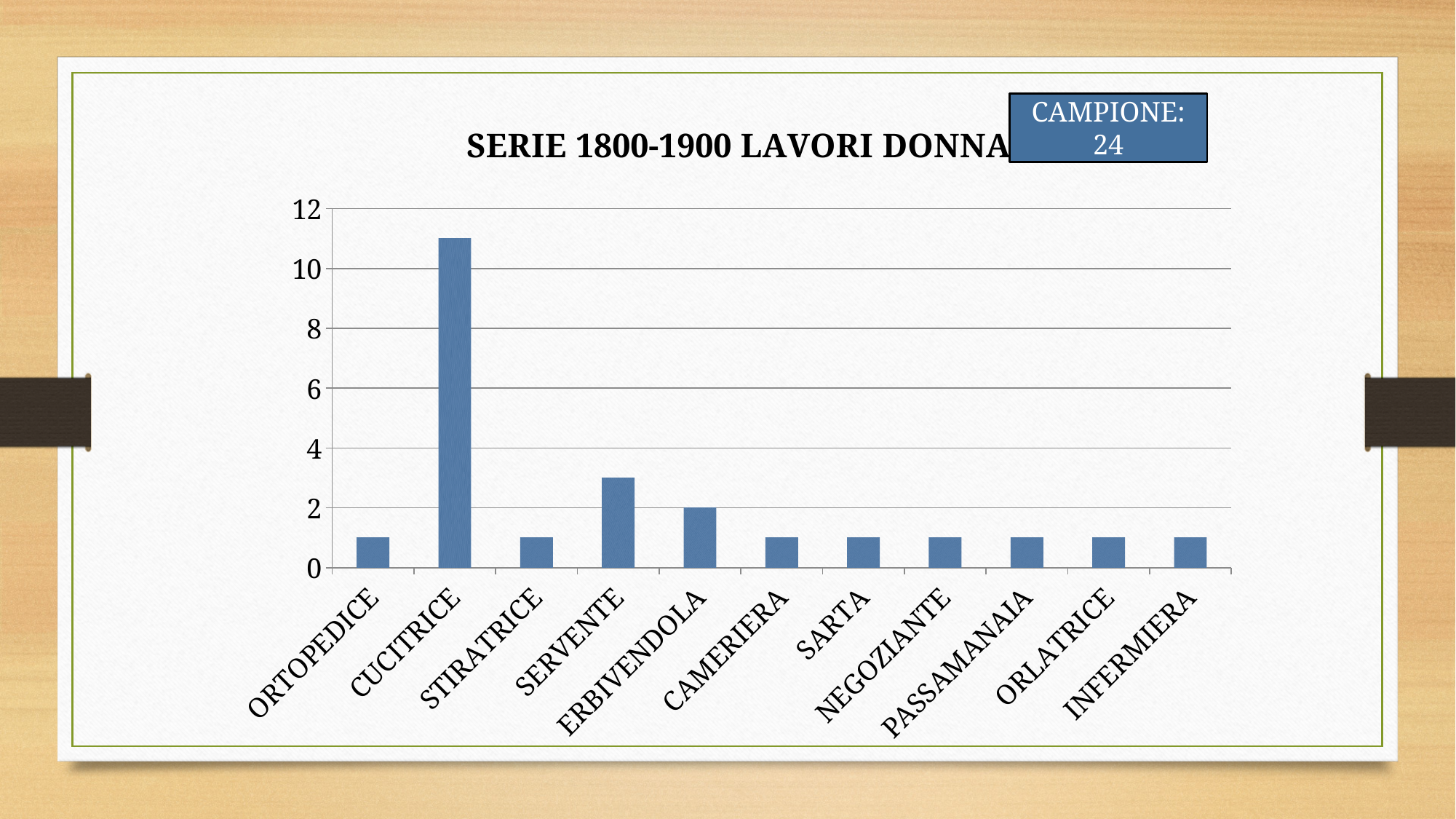
Is the value for ORTOPEDICE greater or less than 2? less Is the value for SERVENTE greater or less than 4? less What is the highest value shown on the vertical axis of the chart? 12 How many categories are shown on the x axis of the chart? 11 Which category has the highest value in the chart? CUCITRICE Which has a larger value, SERVENTE or ERBIVENDOLA? SERVENTE What is the title of the chart? SERIE 1800-1900 LAVORI DONNA Is the value for CUCITRICE greater or less than 10? greater What kind of chart is shown on the slide? bar chart What is the value for ERBIVENDOLA? 2 Which has a larger value, CUCITRICE or SERVENTE? CUCITRICE